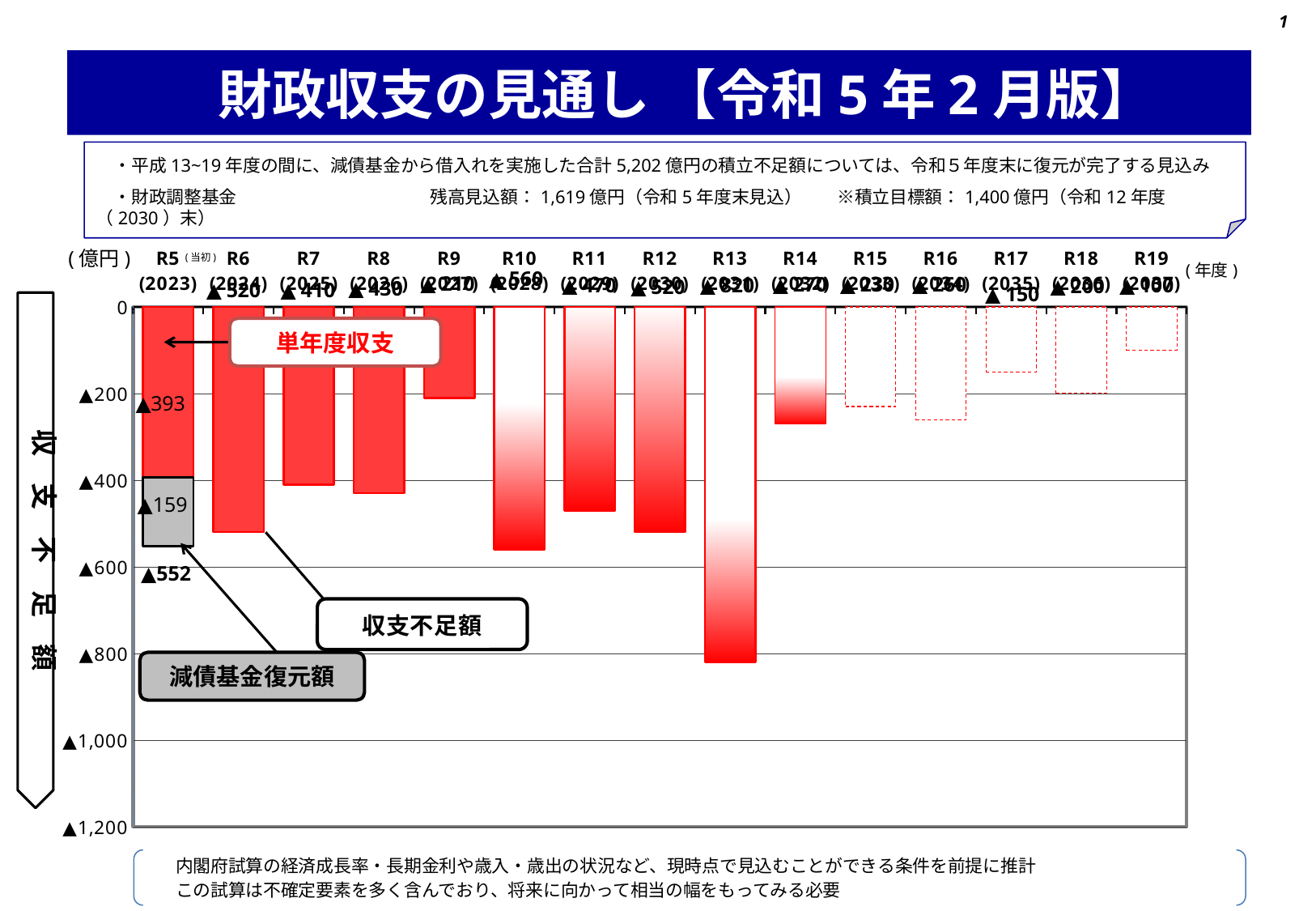
What is the value labelled for R8 (2026)? ▲430 What is the total 収支不足額 shown for R5 (2023)? ▲552 What is the difference between the values for R8 (2026) and R7 (2025)? 20 What is the value labelled for R7 (2025)? ▲410 Is the deficit for R9 (2027) greater or less than 400? less Which has the larger deficit, R6 (2024) or R7 (2025)? R6 (2024) What is the 単年度収支 value for R5 (2023)? ▲393 Which fiscal year has the largest deficit bar in the chart? R13 (2031) What is the 減債基金復元額 value shown for R5 (2023)? ▲159 What is the 単年度収支 value shown for R6 (2024)? ▲520 What kind of chart is shown on the slide? bar chart